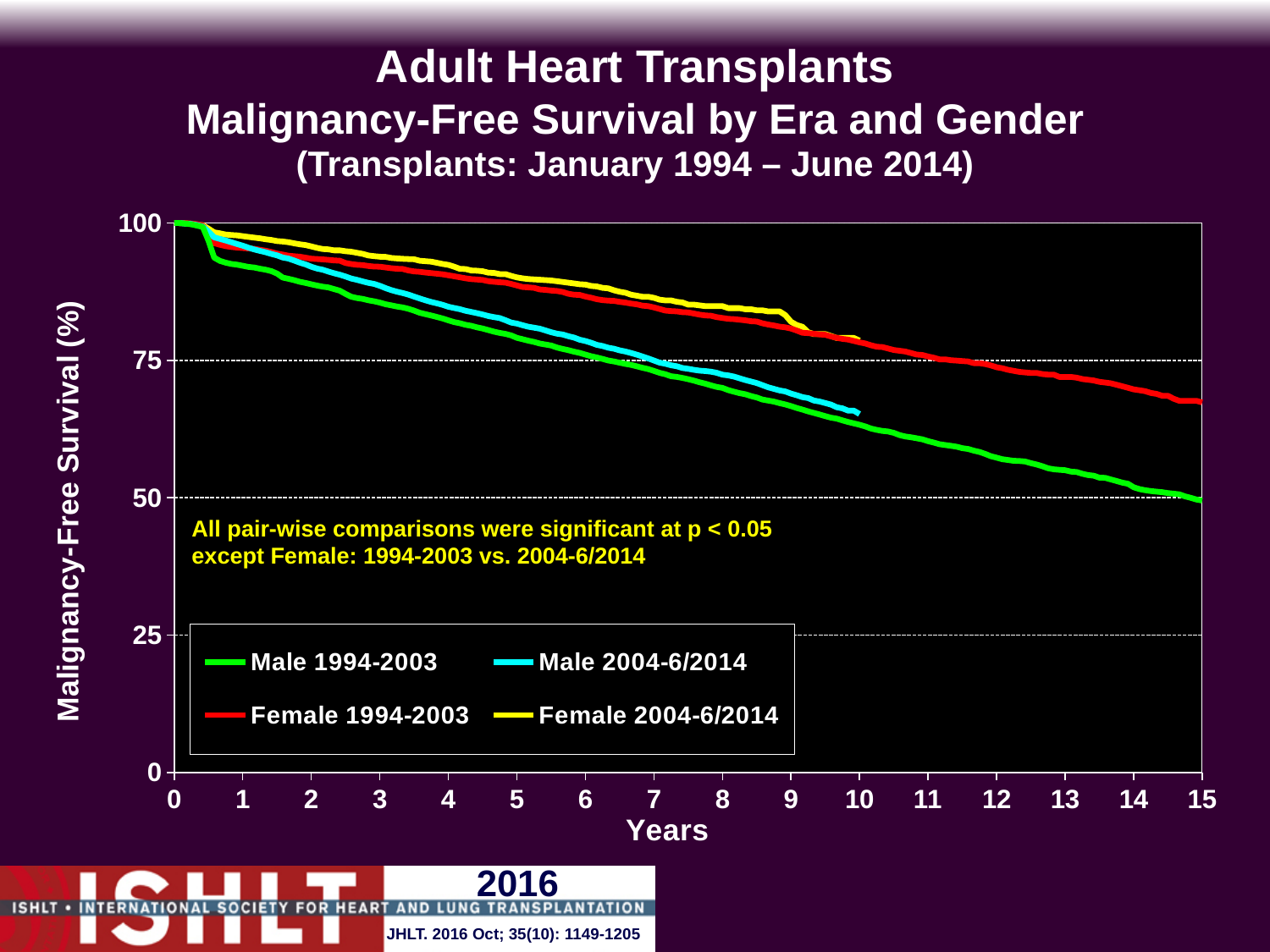
Is the value for Female 2004-6/2014 at year 5 greater or less than 75? greater What is the label of the y axis? Malignancy-Free Survival (%) Is the value for Male 1994-2003 at year 5 greater or less than 75? greater Which series is drawn in green? Male 1994-2003 Is the value for Female 1994-2003 at year 15 greater or less than 50? greater Do the malignancy-free survival curves rise or fall as years since transplant increase? fall At year 10, which is higher: Male 1994-2003 or Female 1994-2003? Female 1994-2003 What kind of chart is shown on the slide? line chart At year 8, which is higher: Male 2004-6/2014 or Female 2004-6/2014? Female 2004-6/2014 How many series does the legend list? 4